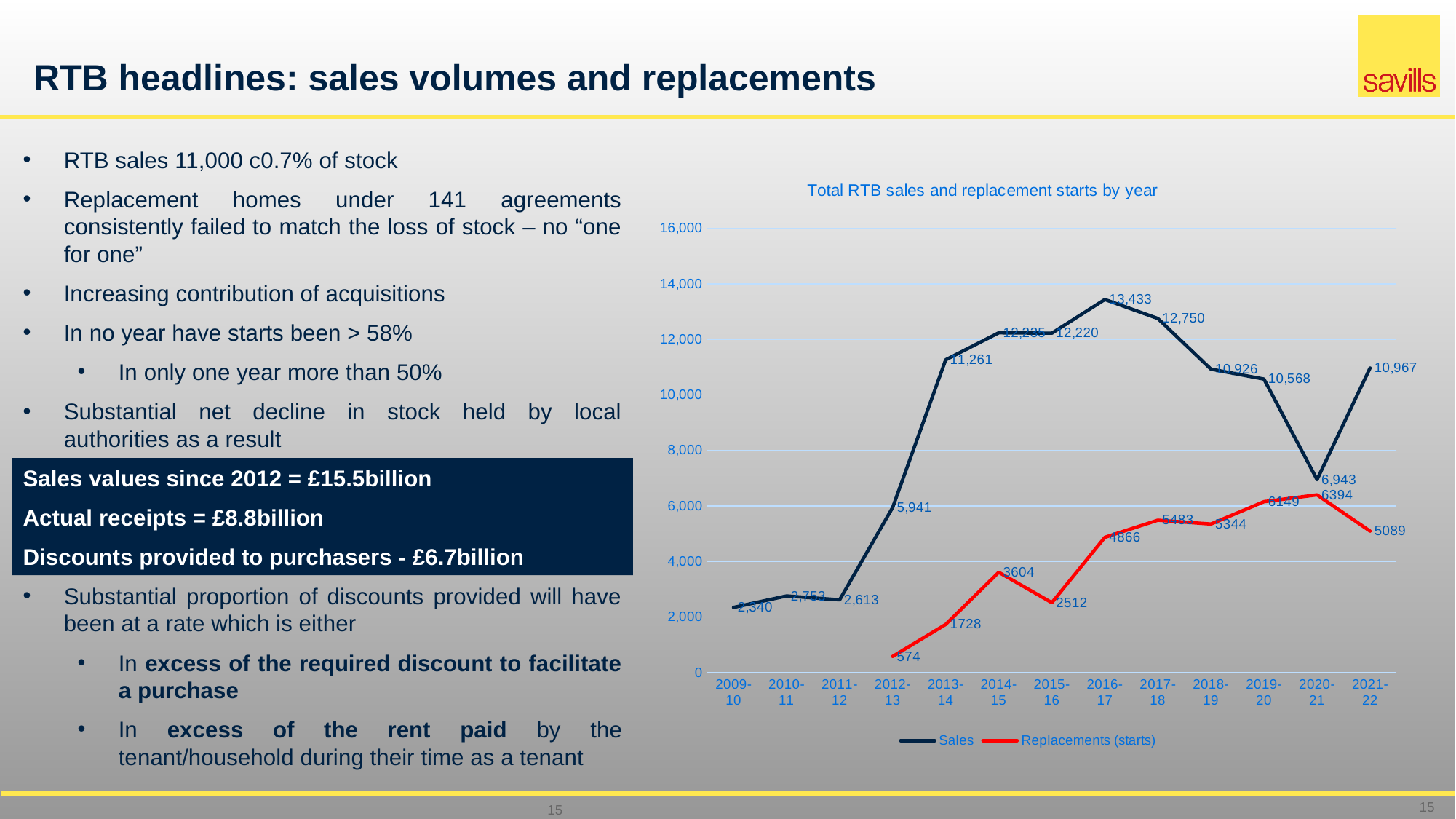
Which is larger: Sales in 2021-22 or Sales in 2019-20? 2021-22 How many series does the chart legend list? 2 How many years are shown on the x axis of the chart? 13 Is the Sales value for 2020-21 greater or less than 8,000? less In which year is the Replacements (starts) series at its highest? 2020-21 What is the title of the chart? Total RTB sales and replacement starts by year What kind of chart is shown on the slide? line chart In which year is the Sales series at its lowest? 2009-10 In which year is the Sales series at its highest? 2016-17 What is the Sales value for 2016-17? 13,433 What is the Replacements (starts) value for 2012-13? 574 What is the difference between Sales in 2016-17 and Sales in 2017-18? 683